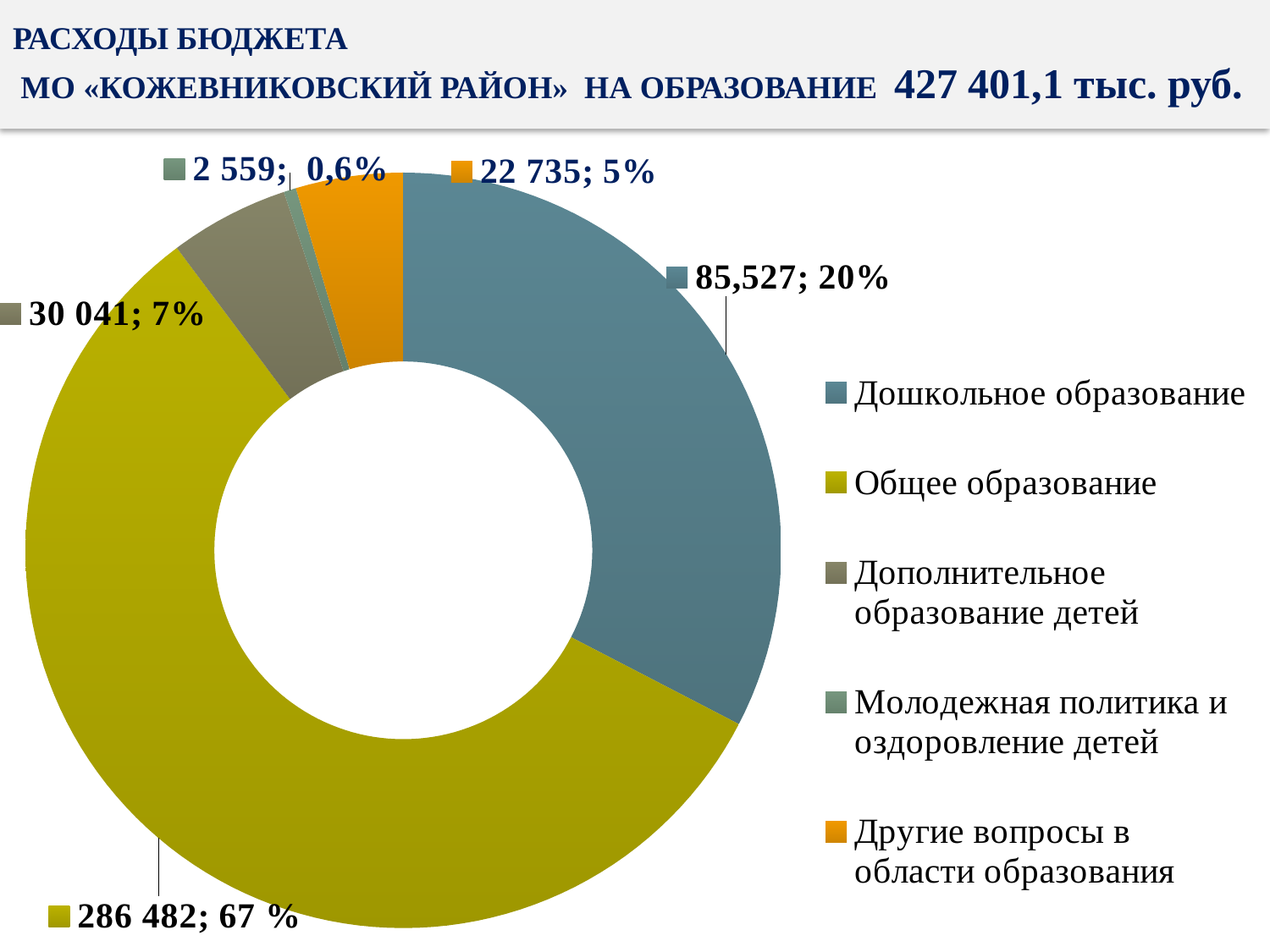
Which category has the largest value? Общее образование What share of the chart does Молодежная политика и оздоровление детей take? 0,6% What is the value for Общее образование? 286 482 What is the value for Другие вопросы в области образования? 22 735 How many categories does the chart show? 5 What total amount is stated in the slide title? 427 401,1 тыс. руб. What share of the chart does Дошкольное образование take? 20% Which is larger: Дополнительное образование детей or Другие вопросы в области образования? Дополнительное образование детей What is the value for Дополнительное образование детей? 30 041 Which category has the smallest value? Молодежная политика и оздоровление детей What kind of chart is shown on the slide? Doughnut (pie) chart What is the difference between the values for Дополнительное образование детей and Другие вопросы в области образования? 7 306